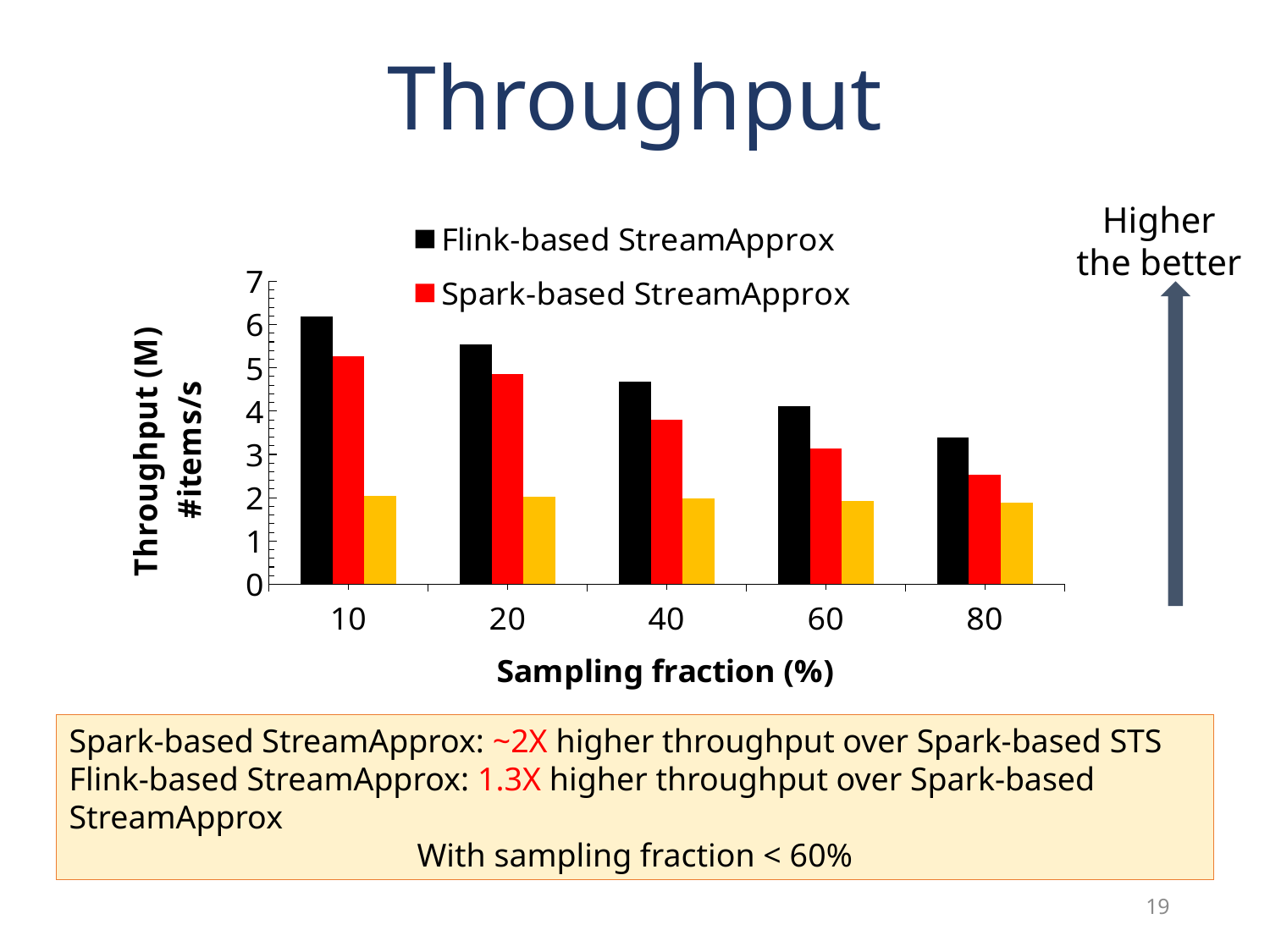
What is the title of the x axis? Sampling fraction (%) At which sampling fraction is the Flink-based StreamApprox throughput highest? 10 At a sampling fraction of 40%, which is larger: Flink-based StreamApprox or Spark-based StreamApprox? Flink-based StreamApprox Does the Flink-based StreamApprox throughput rise or fall as the sampling fraction increases? fall At which sampling fraction is the Spark-based StreamApprox throughput lowest? 80 How many series does the legend list? 2 Is the Flink-based StreamApprox value at a sampling fraction of 40% greater or less than 4? greater What kind of chart is shown on the slide? bar chart How many sampling fraction categories are shown on the x axis? 5 Is the Flink-based StreamApprox value at a sampling fraction of 10% greater or less than 5? greater Is the Spark-based StreamApprox value at a sampling fraction of 80% greater or less than 3? less Which colour represents Spark-based StreamApprox in the legend? red